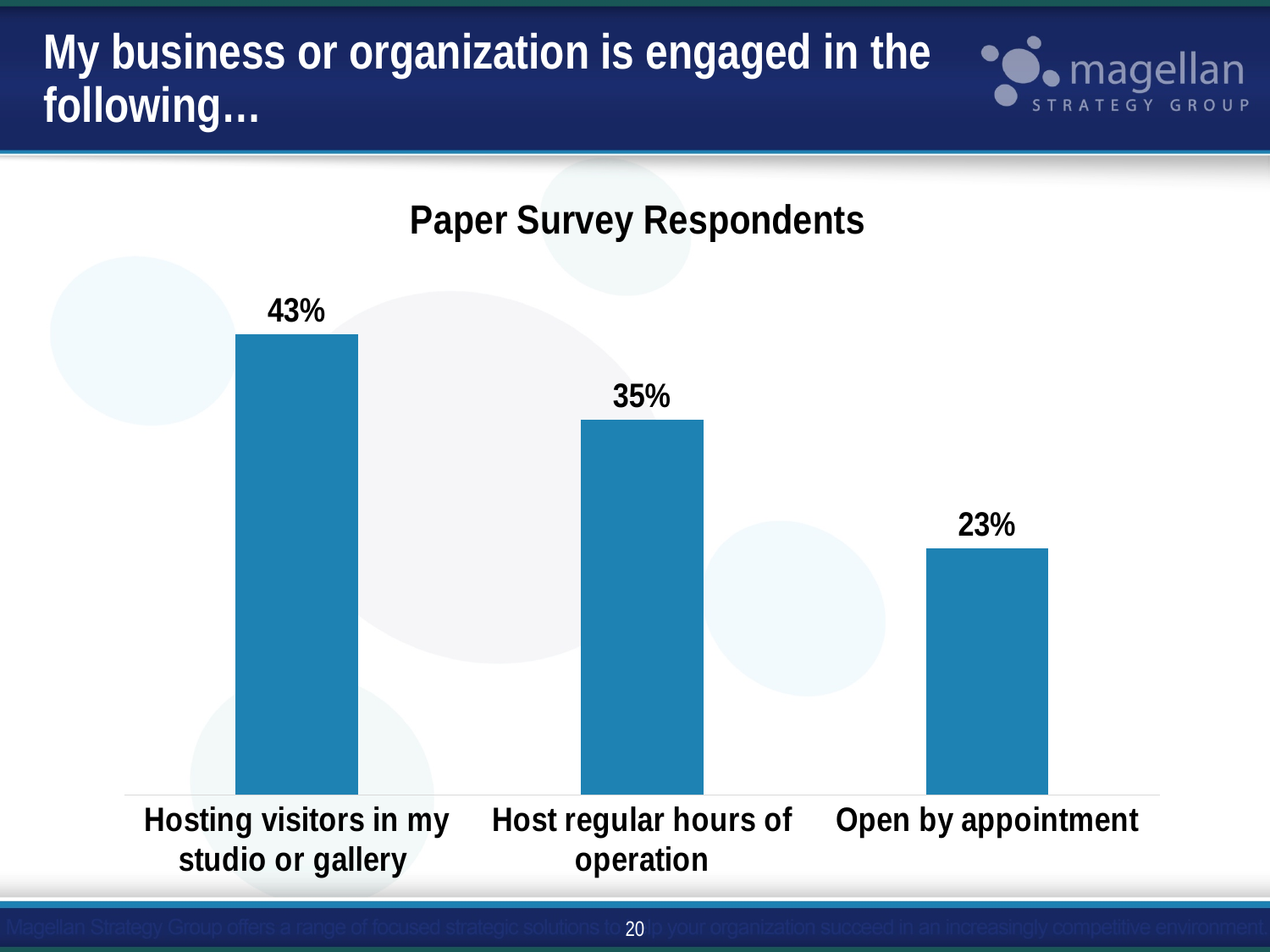
Which category has the lowest percentage of paper survey respondents? Open by appointment What kind of chart is shown on the slide? Bar chart Which is larger: the percentage for 'Host regular hours of operation' or for 'Open by appointment'? Host regular hours of operation What percentage of paper survey respondents are open by appointment? 23% What percentage of paper survey respondents host regular hours of operation? 35% Do the values rise or fall from left to right across the categories? Fall What percentage of paper survey respondents are engaged in hosting visitors in their studio or gallery? 43% Which category has the highest percentage of paper survey respondents? Hosting visitors in my studio or gallery What is the difference in percentage points between 'Hosting visitors in my studio or gallery' and 'Open by appointment'? 20 percentage points What is the difference in percentage points between 'Host regular hours of operation' and 'Open by appointment'? 12 percentage points How many categories are shown in the chart? 3 What is the title of the chart? Paper Survey Respondents